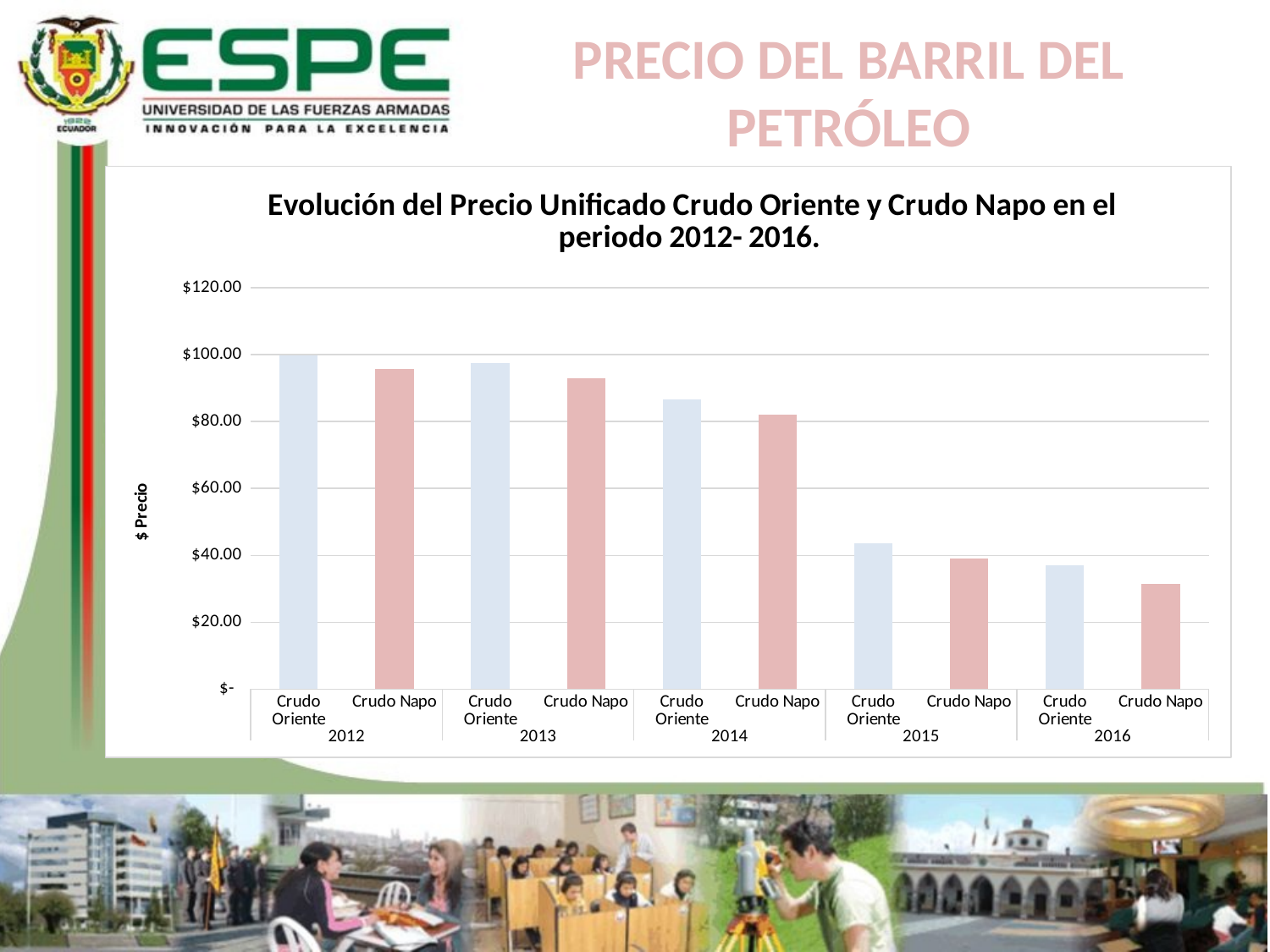
What is the label of the vertical axis? $ Precio How many bars are plotted in the chart? 10 What kind of chart is shown on the slide? bar chart Is the value for Crudo Oriente in 2015 greater or less than $60.00? less Do the Crudo Oriente values rise or fall from 2012 to 2016? fall Is the value for Crudo Napo in 2016 greater or less than $40.00? less What is the title of the chart? Evolución del Precio Unificado Crudo Oriente y Crudo Napo en el periodo 2012- 2016. Is the value for Crudo Oriente in 2014 greater or less than $80.00? greater Which bar has the lowest value in the chart? Crudo Napo 2016 Which bar has the highest value in the chart? Crudo Oriente 2012 Which is larger, Crudo Oriente in 2014 or Crudo Napo in 2014? Crudo Oriente in 2014